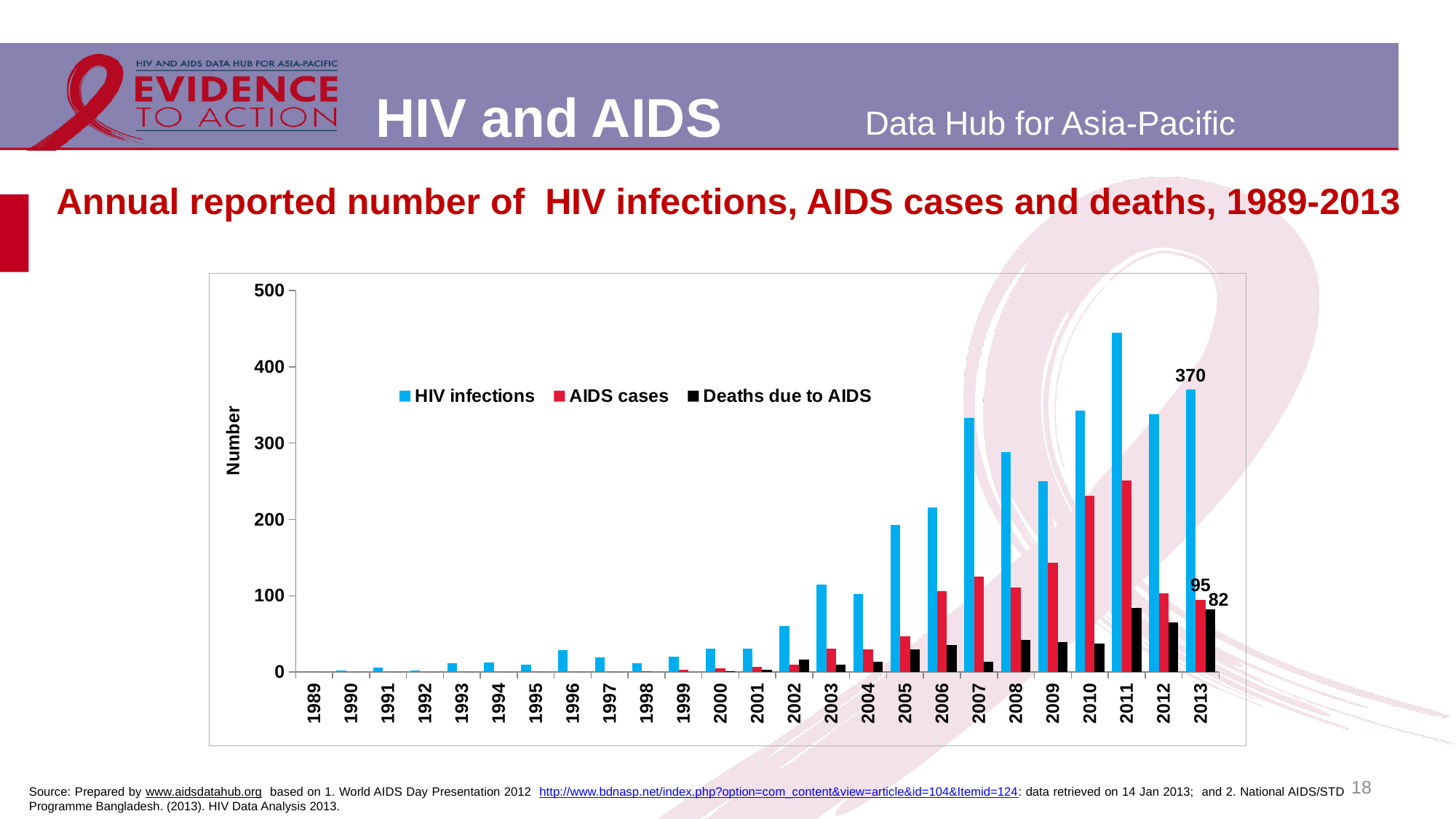
Overall, do HIV infections rise or fall from 1989 to 2013? Rise What is the reported number of HIV infections in 2013? 370 What is the reported number of AIDS cases in 2013? 95 What type of chart is shown on the slide? Bar chart How many years are shown on the x axis? 25 In 2013, which is larger: AIDS cases or deaths due to AIDS? AIDS cases How many series does the legend list? 3 What are the three series listed in the legend? HIV infections, AIDS cases, Deaths due to AIDS What is the difference between HIV infections and AIDS cases in 2013? 275 Which year has the highest number of HIV infections? 2011 What is the reported number of deaths due to AIDS in 2013? 82 Is the number of HIV infections in 2011 greater or less than 400? greater